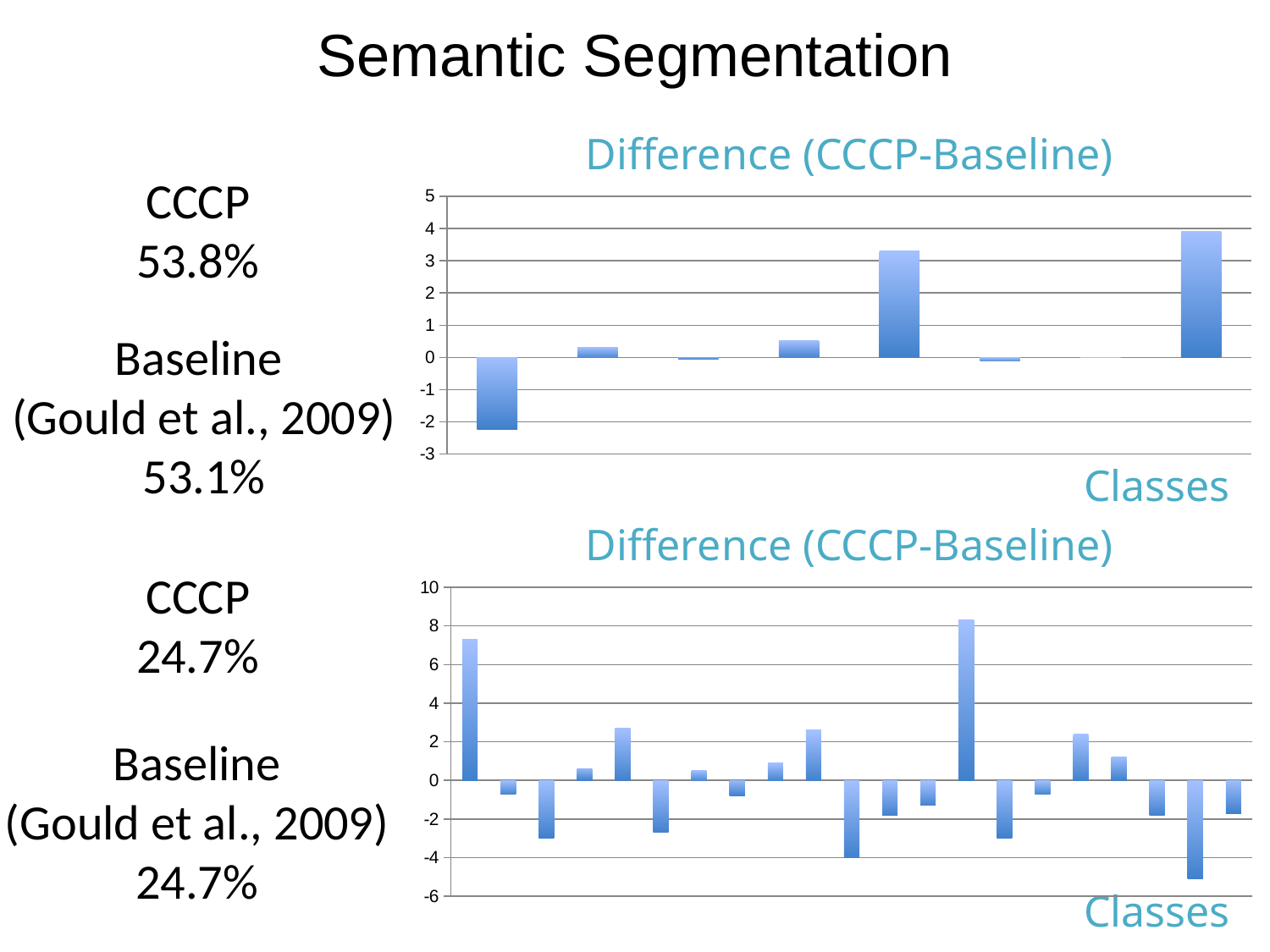
What label appears under the x axis of the bottom chart? Classes In the bottom chart, which is larger: the leftmost bar or the rightmost bar? the leftmost bar What kind of chart is the bottom chart on the slide? bar chart In the top chart, is the value of the rightmost bar greater or less than 3? greater In the top chart, which is larger: the leftmost bar or the rightmost bar? the rightmost bar In the top chart, is the value of the leftmost bar greater or less than -1? less In the bottom chart, is the value of the lowest bar greater or less than -4? less What is the title of the top chart? Difference (CCCP-Baseline) What kind of chart is the top chart titled "Difference (CCCP-Baseline)"? bar chart